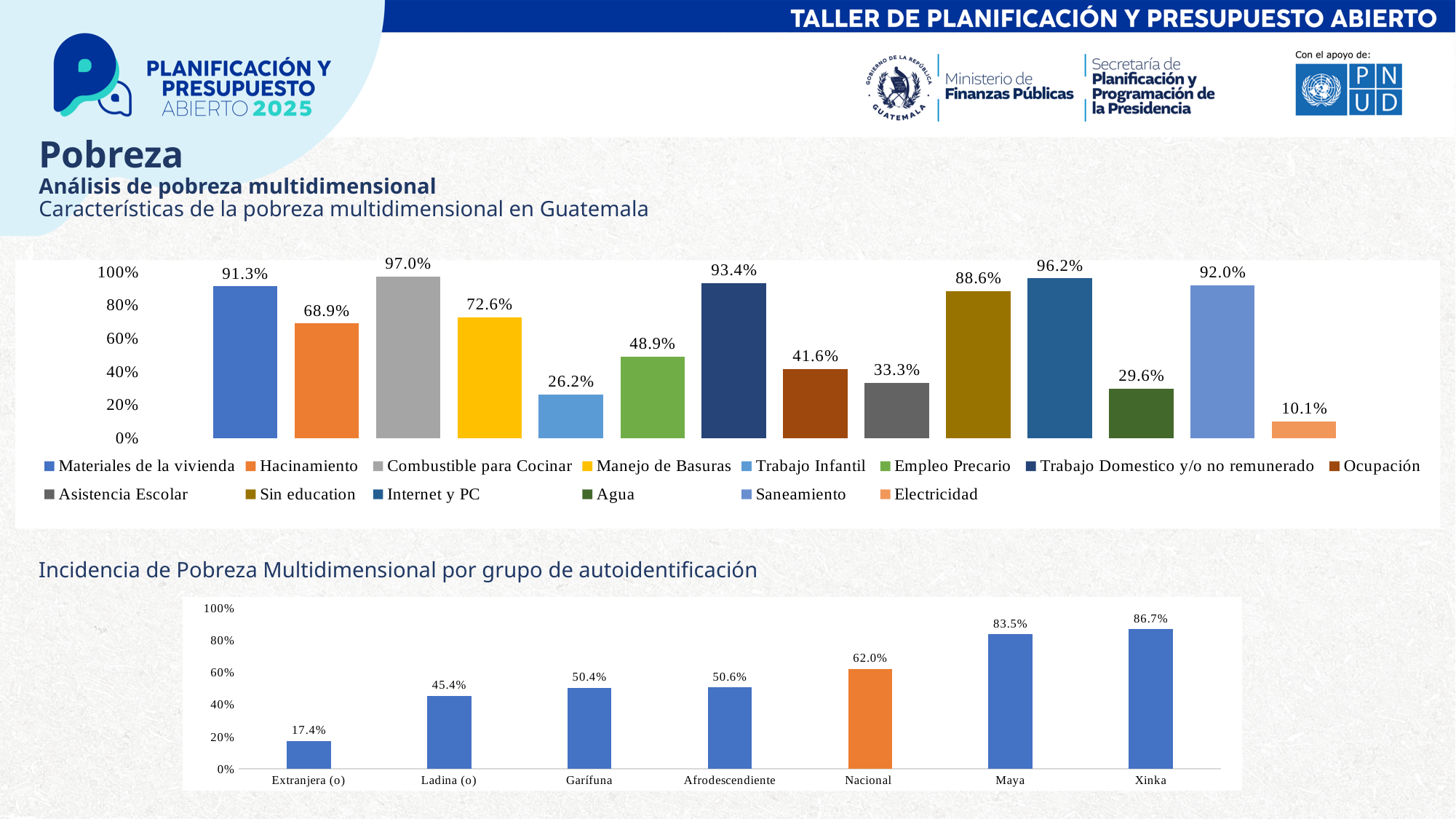
In the top chart (Características de la pobreza multidimensional en Guatemala), what is the value for Trabajo Infantil? 26.2% In the bottom chart (Incidencia de Pobreza Multidimensional por grupo de autoidentificación), which group has the highest value? Xinka In the top chart (Características de la pobreza multidimensional en Guatemala), which series has the lowest value? Electricidad What kind of chart is the bottom chart (Incidencia de Pobreza Multidimensional por grupo de autoidentificación)? Bar chart In the top chart (Características de la pobreza multidimensional en Guatemala), what is the difference between Saneamiento and Agua? 62.4% In the bottom chart (Incidencia de Pobreza Multidimensional por grupo de autoidentificación), how many groups are shown? 7 In the top chart (Características de la pobreza multidimensional en Guatemala), which is larger: Hacinamiento or Manejo de Basuras? Manejo de Basuras In the top chart (Características de la pobreza multidimensional en Guatemala), which series has the highest value? Combustible para Cocinar In the bottom chart (Incidencia de Pobreza Multidimensional por grupo de autoidentificación), what is the difference between Maya and Extranjera (o)? 66.1% In the top chart (Características de la pobreza multidimensional en Guatemala), how many series does the legend list? 14 In the bottom chart (Incidencia de Pobreza Multidimensional por grupo de autoidentificación), what is the value for Nacional? 62.0% In the top chart (Características de la pobreza multidimensional en Guatemala), what is the value for Combustible para Cocinar? 97.0%